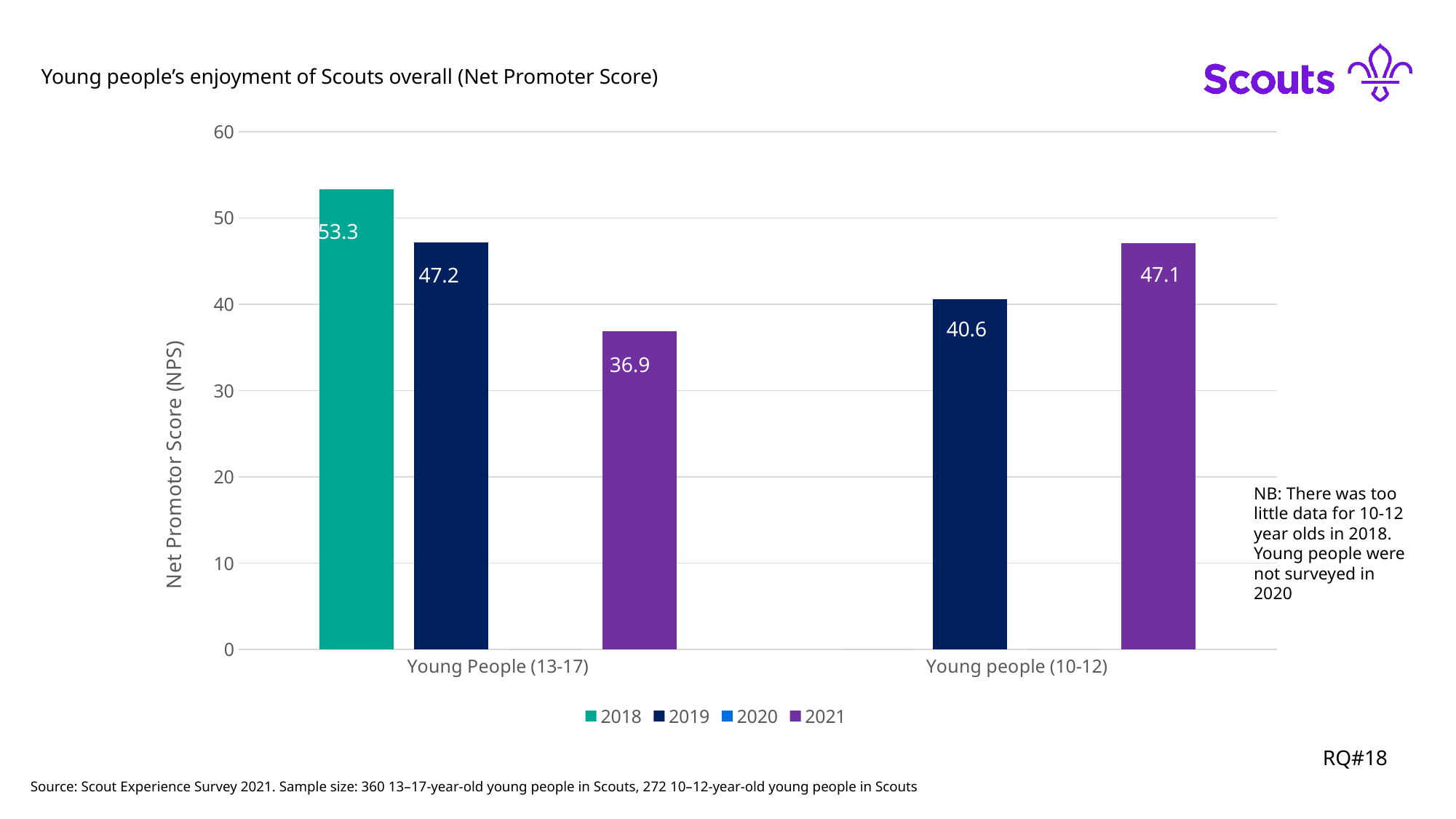
Which year has the lowest Net Promoter Score for Young People (13-17)? 2021 What is the Net Promoter Score for Young people (10-12) in 2021? 47.1 What is the Net Promoter Score for Young people (10-12) in 2019? 40.6 How many series does the legend list? 4 What is the label of the vertical axis? Net Promotor Score (NPS) Which is larger: the 2021 score for Young People (13-17) or the 2021 score for Young people (10-12)? Young people (10-12) What is the Net Promoter Score for Young People (13-17) in 2018? 53.3 What kind of chart is shown on the slide? Bar chart Which year has the highest Net Promoter Score for Young People (13-17)? 2018 What is the difference between the 2019 and 2021 Net Promoter Scores for Young People (13-17)? 10.3 Is the 2019 value for Young People (13-17) greater or less than 40? greater What is the Net Promoter Score for Young People (13-17) in 2021? 36.9